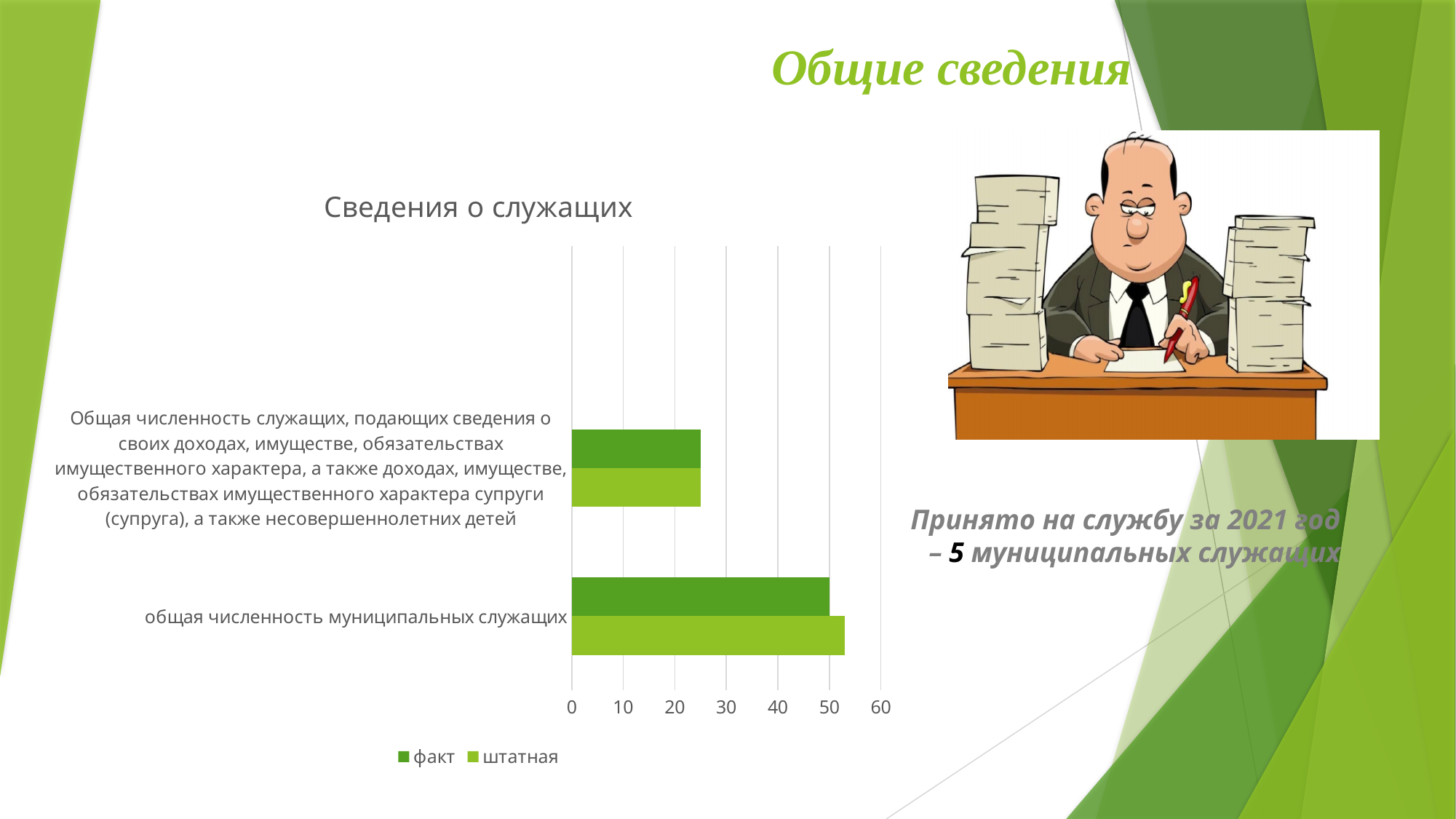
What are the series names listed in the legend? факт, штатная How many series does the chart legend list? 2 What kind of chart is shown on the slide? bar chart What is the title of the chart? Сведения о служащих Is the факт value for 'общая численность муниципальных служащих' greater or less than 60? less How many categories are shown on the chart? 2 Is the штатная value for 'общая численность муниципальных служащих' greater or less than 40? greater Which category has the higher факт value? общая численность муниципальных служащих For 'общая численность муниципальных служащих', which series has the larger value, факт or штатная? штатная Is the штатная value for 'Общая численность служащих, подающих сведения о своих доходах...' greater or less than 20? greater